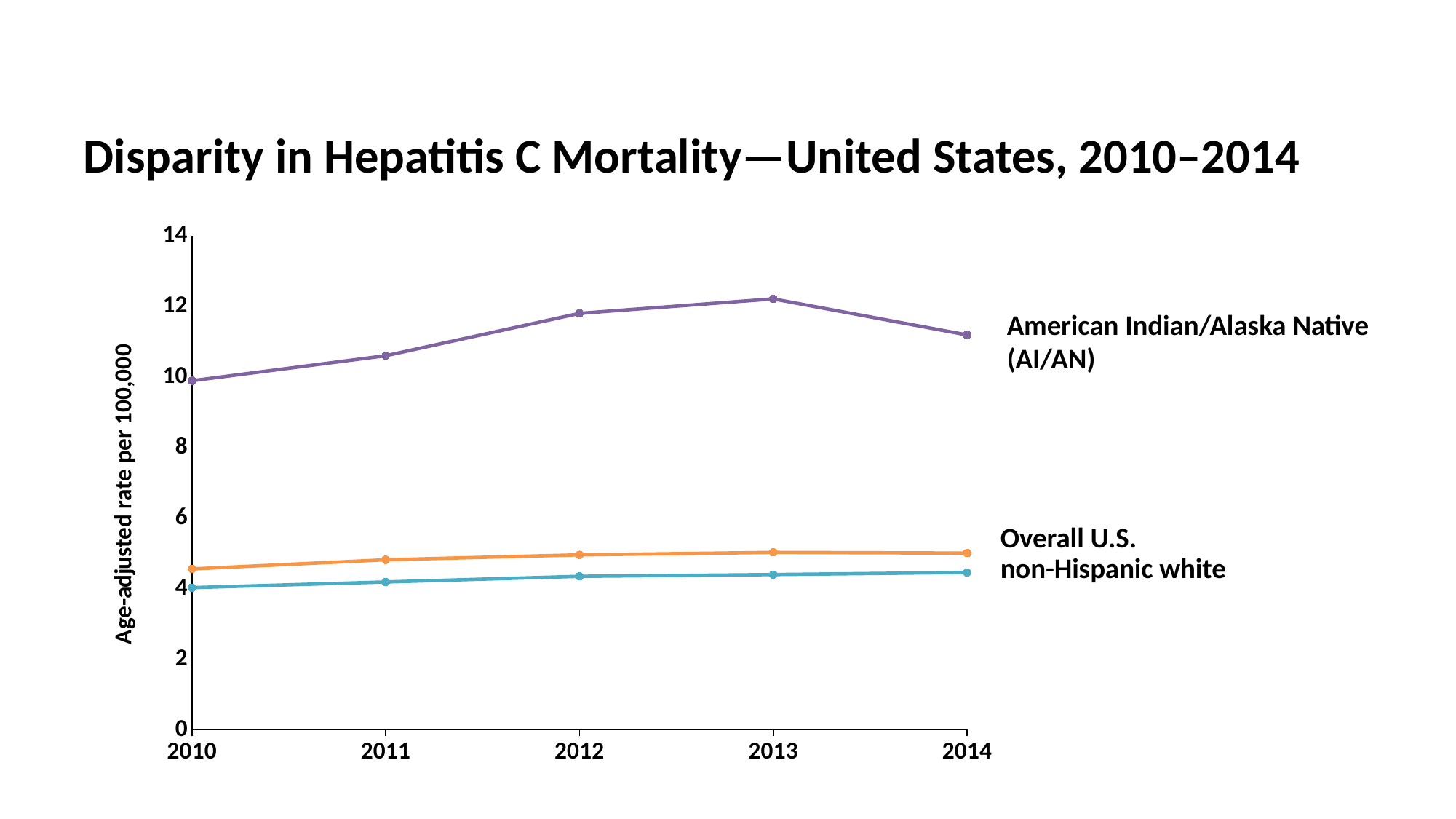
Is the value for Overall U.S. in 2013 greater or less than 6? less Is the value for American Indian/Alaska Native (AI/AN) in 2011 greater or less than 10? greater How many years are plotted along the x axis? 5 In which year does the American Indian/Alaska Native (AI/AN) line reach its highest value? 2013 What kind of chart is shown on the slide? Line chart Is the value for non-Hispanic white in 2014 greater or less than 6? less How many series are plotted on the chart? 3 In 2011, which series has the larger value: Overall U.S. or non-Hispanic white? Overall U.S. What is the label on the y axis of the chart? Age-adjusted rate per 100,000 In 2012, which series has the larger value: American Indian/Alaska Native (AI/AN) or Overall U.S.? American Indian/Alaska Native (AI/AN) Does the American Indian/Alaska Native (AI/AN) line rise or fall from 2013 to 2014? Fall In which year is the American Indian/Alaska Native (AI/AN) value lowest? 2010